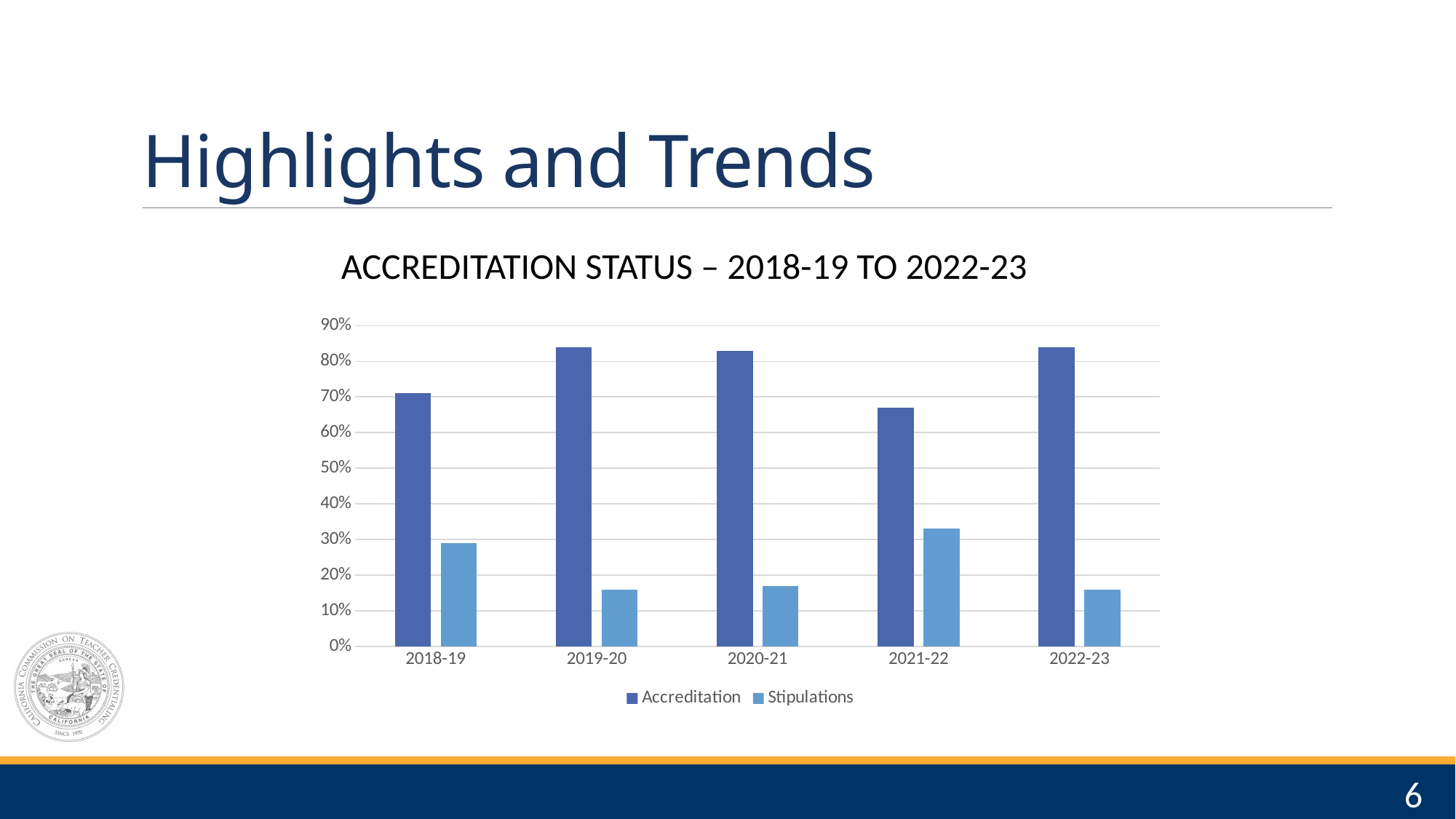
Is the Stipulations value for 2021-22 greater or less than 30%? greater Is the Stipulations value for 2019-20 greater or less than 20%? less What is the title of the chart? ACCREDITATION STATUS – 2018-19 TO 2022-23 Is the Accreditation value for 2021-22 greater or less than 70%? less What kind of chart is shown on the slide? bar chart Which is larger, the Stipulations value for 2018-19 or for 2019-20? 2018-19 How many series does the legend list? 2 Which year has the lowest Accreditation value? 2021-22 How many academic years are shown on the x axis? 5 Which is larger, the Accreditation value for 2018-19 or for 2021-22? 2018-19 Which year has the highest Stipulations value? 2021-22